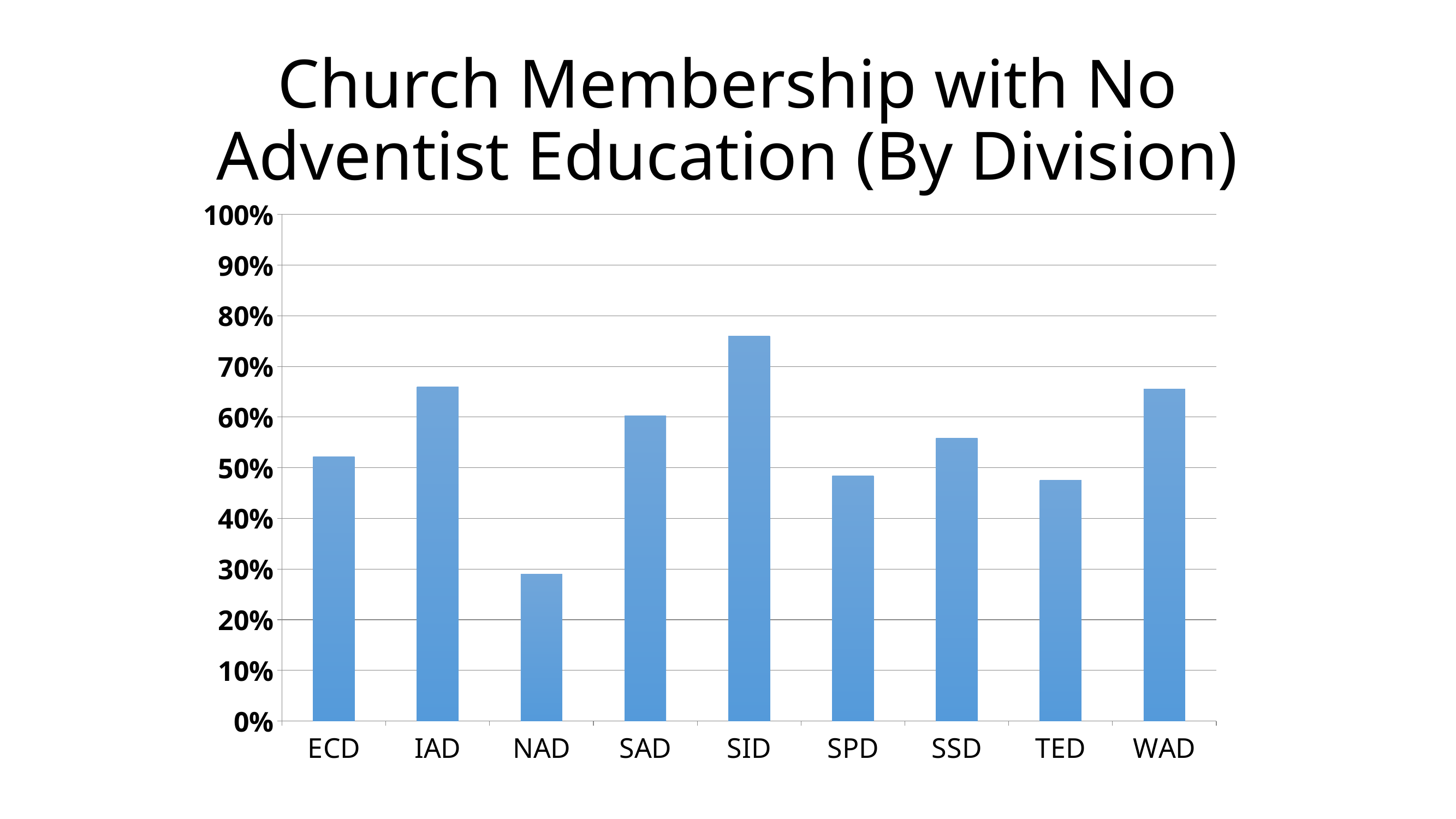
Is the value for NAD greater or less than 40%? less Which has a higher value, SID or IAD? SID How many divisions are shown on the x axis? 9 Which has a higher value, SAD or TED? SAD Is the value for SPD greater or less than 60%? less What type of chart is shown on the slide? bar chart What is the title of the chart? Church Membership with No Adventist Education (By Division) Which division has the highest percentage of church membership with no Adventist education? SID Which division has the lowest percentage of church membership with no Adventist education? NAD Which has a higher value, NAD or SPD? SPD Is the value for IAD greater or less than 60%? greater